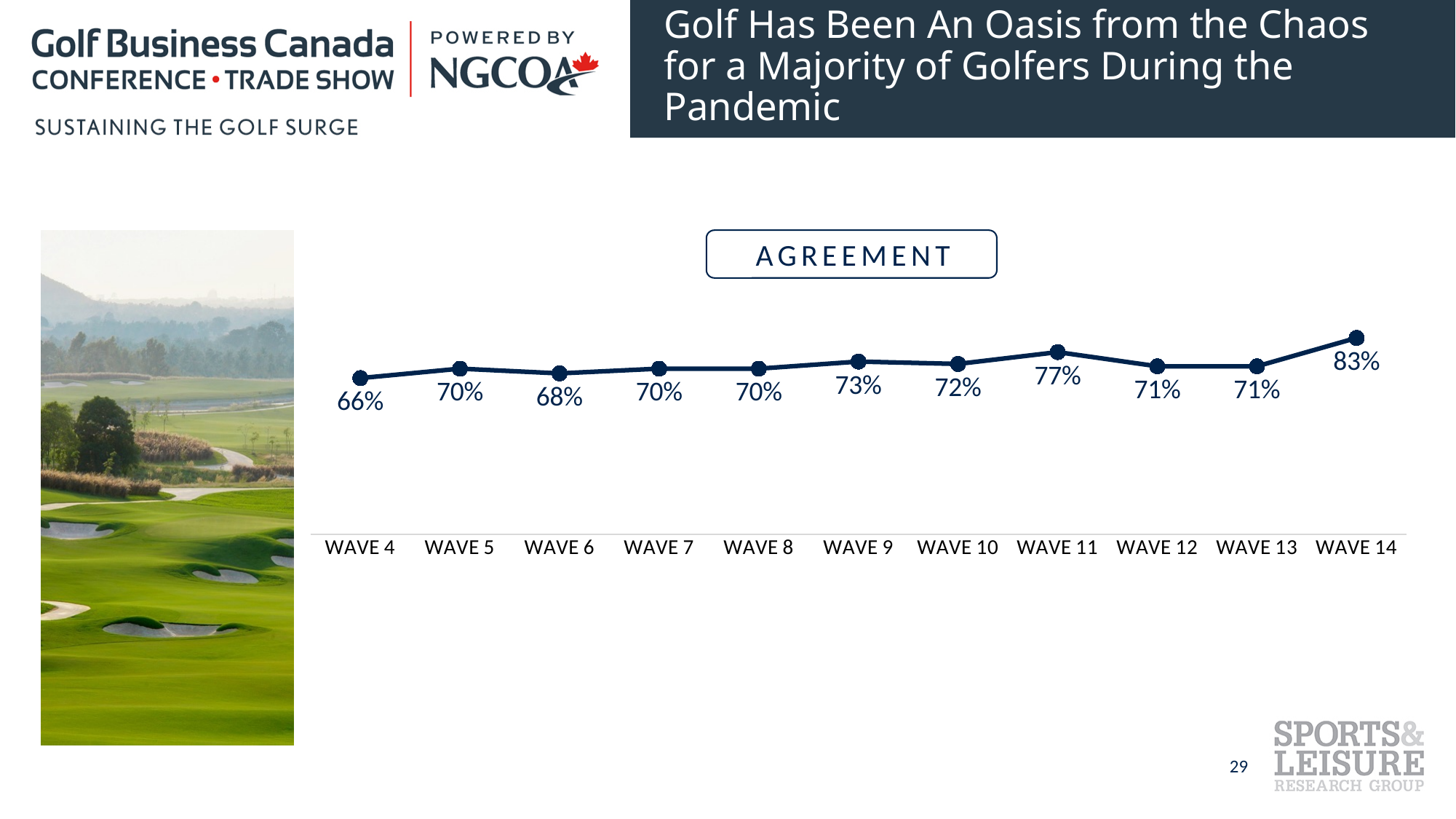
Which wave has the highest agreement value? Wave 14 Which has a higher agreement value, Wave 6 or Wave 9? Wave 9 What is the agreement value for Wave 14? 83% What is the difference between the agreement values for Wave 14 and Wave 4? 17% What is the agreement value for Wave 9? 73% Which wave has the lowest agreement value? Wave 4 What is the difference between the agreement values for Wave 11 and Wave 12? 6% What is the agreement value for Wave 4? 66% What is the label shown in the box above the chart? AGREEMENT What kind of chart is shown on the slide? Line chart What is the agreement value for Wave 11? 77% How many waves are plotted on the chart? 11